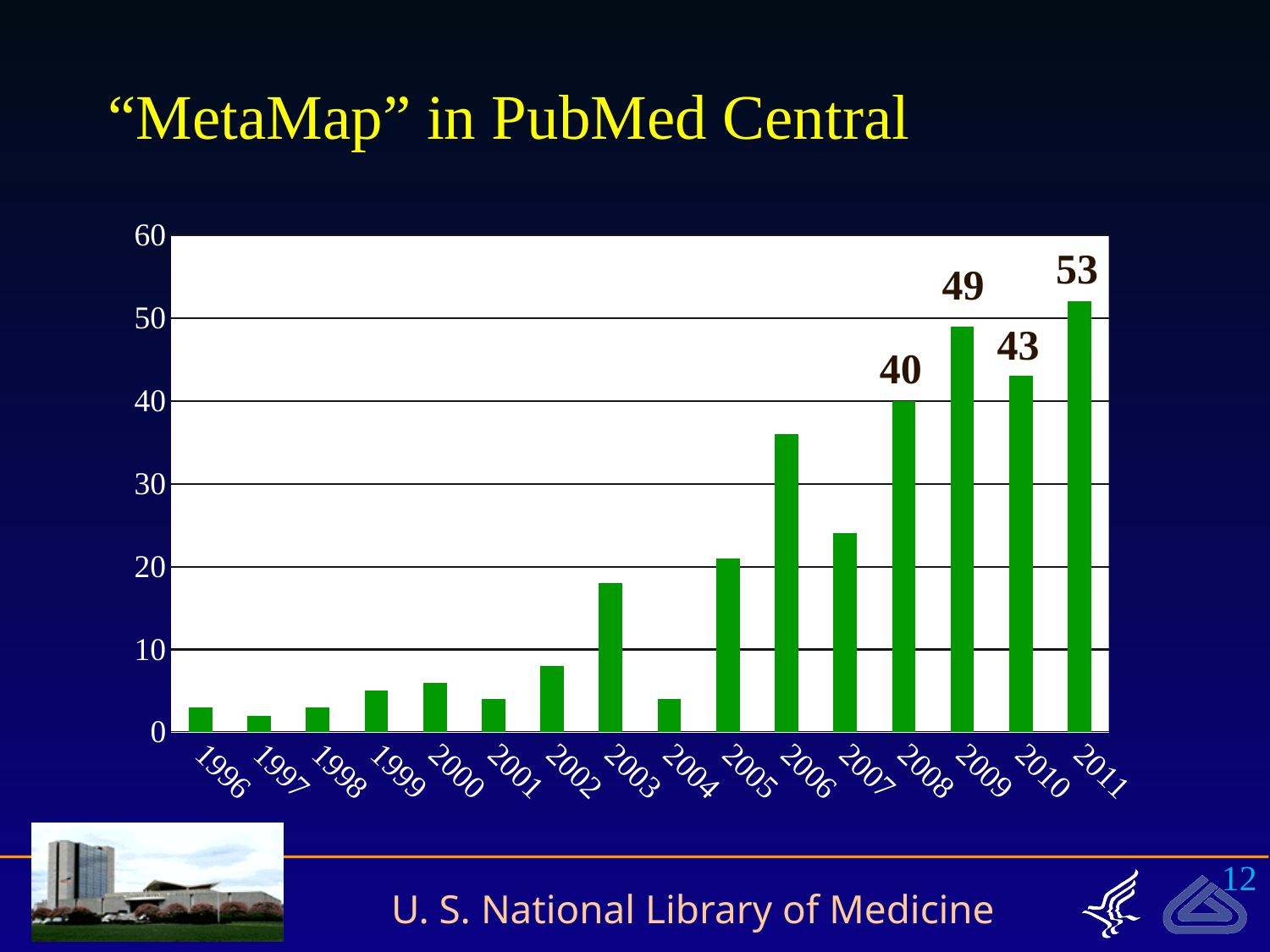
What is the value for 2011? 53 How many years are shown on the x axis? 16 Which is larger, the value for 2009 or the value for 2010? 2009 What is the value for 2009? 49 What is the value for 2008? 40 What is the value for 2010? 43 Which year has the highest value? 2011 What kind of chart is shown on the slide? bar chart Is the value for 2006 greater or less than 30? greater What is the title of the slide? "MetaMap" in PubMed Central Is the value for 2004 greater or less than 10? less What is the difference between the values for 2011 and 2008? 13